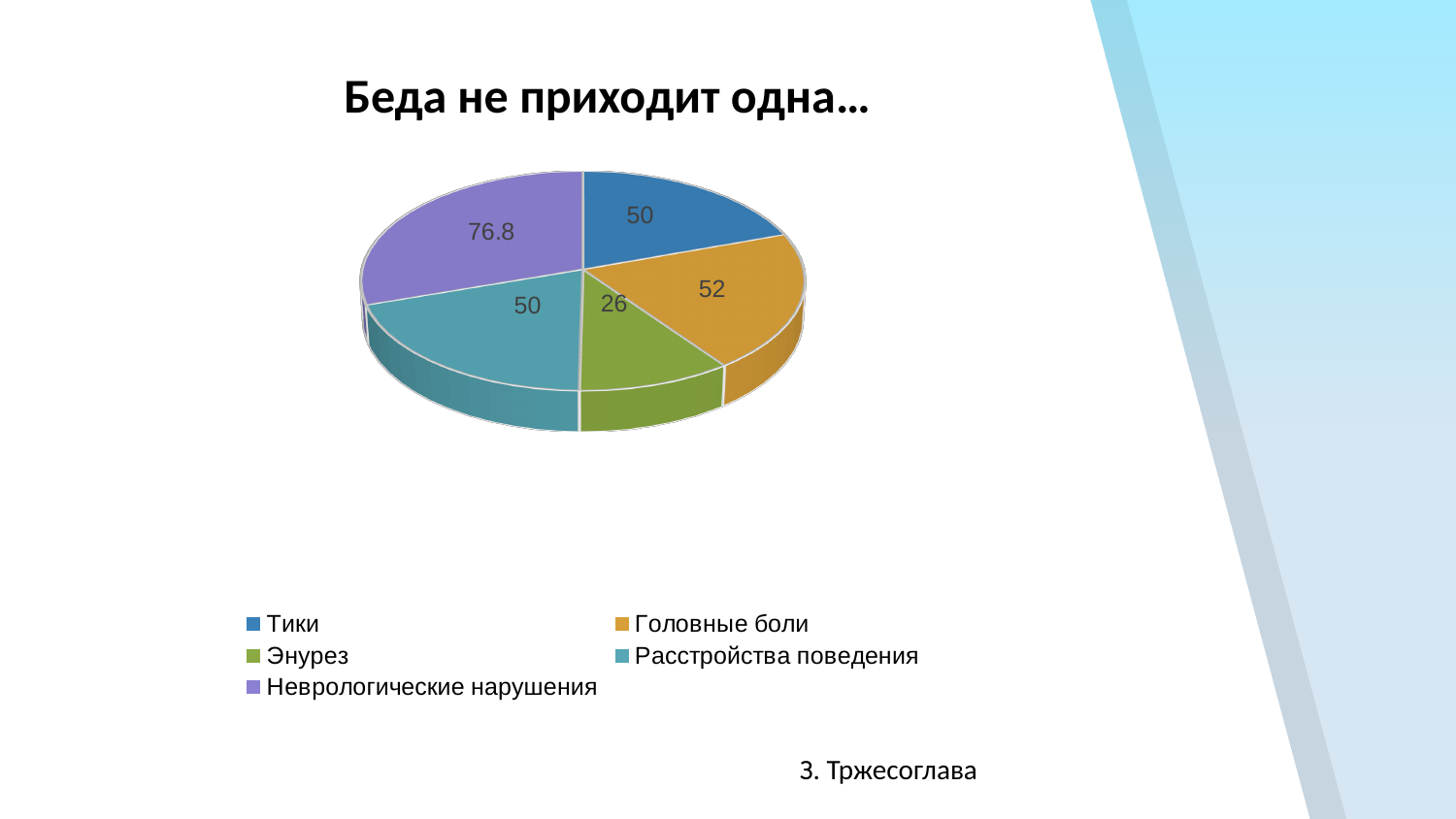
How many categories does the pie chart have? 5 Which category is shown in purple? Неврологические нарушения What is the value for Неврологические нарушения? 76.8 What is the title of the chart? Беда не приходит одна… Which is larger, the value for Головные боли or the value for Тики? Головные боли What is the value for Головные боли? 52 Which category has the smallest slice? Энурез Which category has the largest slice? Неврологические нарушения What type of chart is shown on the slide? Pie chart What is the value for Расстройства поведения? 50 What is the value for Энурез? 26 What is the difference between the values for Неврологические нарушения and Энурез? 50.8